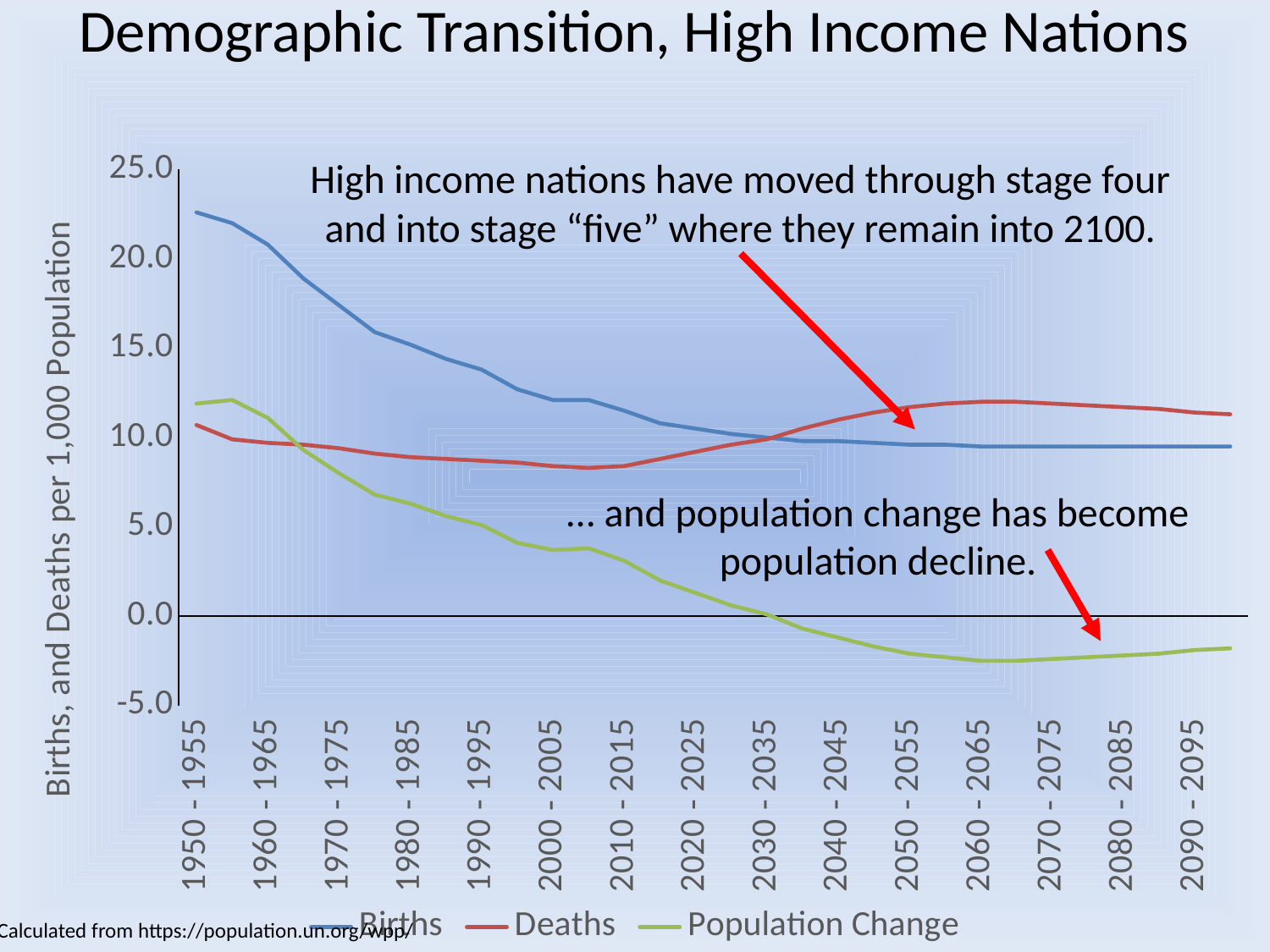
Is the Births value for 2090 - 2095 greater or less than 10.0? less Is the Population Change value higher in 1950 - 1955 or in 2090 - 2095? 1950 - 1955 Is the Population Change value for 2090 - 2095 greater or less than 0.0? less What are the three series named in the legend? Births, Deaths, Population Change Is the Deaths value for 1950 - 1955 greater or less than 15.0? less What kind of chart is shown on the slide? line chart How many series does the legend list? 3 Do the Births values rise or fall from 1950 - 1955 to 2090 - 2095? fall Which series has the higher value in 2090 - 2095, Births or Deaths? Deaths What is the label on the vertical axis? Births, and Deaths per 1,000 Population Which series has the higher value in 1950 - 1955, Births or Deaths? Births